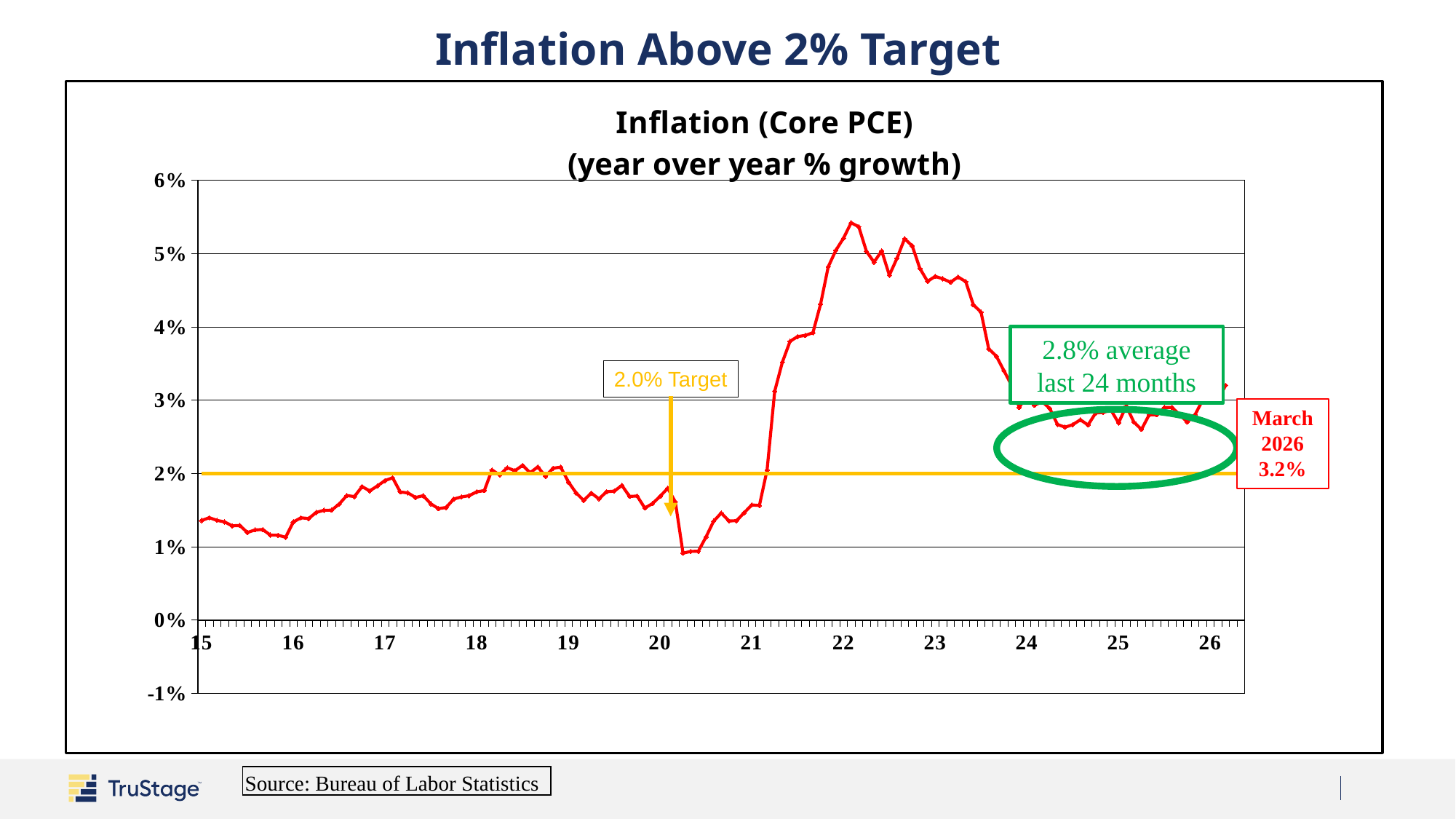
What is the Core PCE inflation value labelled for March 2026? 3.2% Is the peak value of the line, reached around 22, greater or less than 5%? greater What is the average Core PCE inflation over the last 24 months, as annotated on the chart? 2.8% What kind of chart is shown on the slide? line chart Does the line rise or fall between 22 and 24? fall Which is larger: the March 2026 value or the 2.8% average of the last 24 months? March 2026 value By how much does the March 2026 value of 3.2% exceed the 2.0% target? 1.2% Does the line rise or fall between 21 and 22? rise Is the value at the start of the series in 15 greater or less than 2%? less What inflation target is marked by the horizontal line on the chart? 2.0% What is the title of the chart? Inflation (Core PCE) (year over year % growth) Around which x-axis label does the line reach its highest point? 22